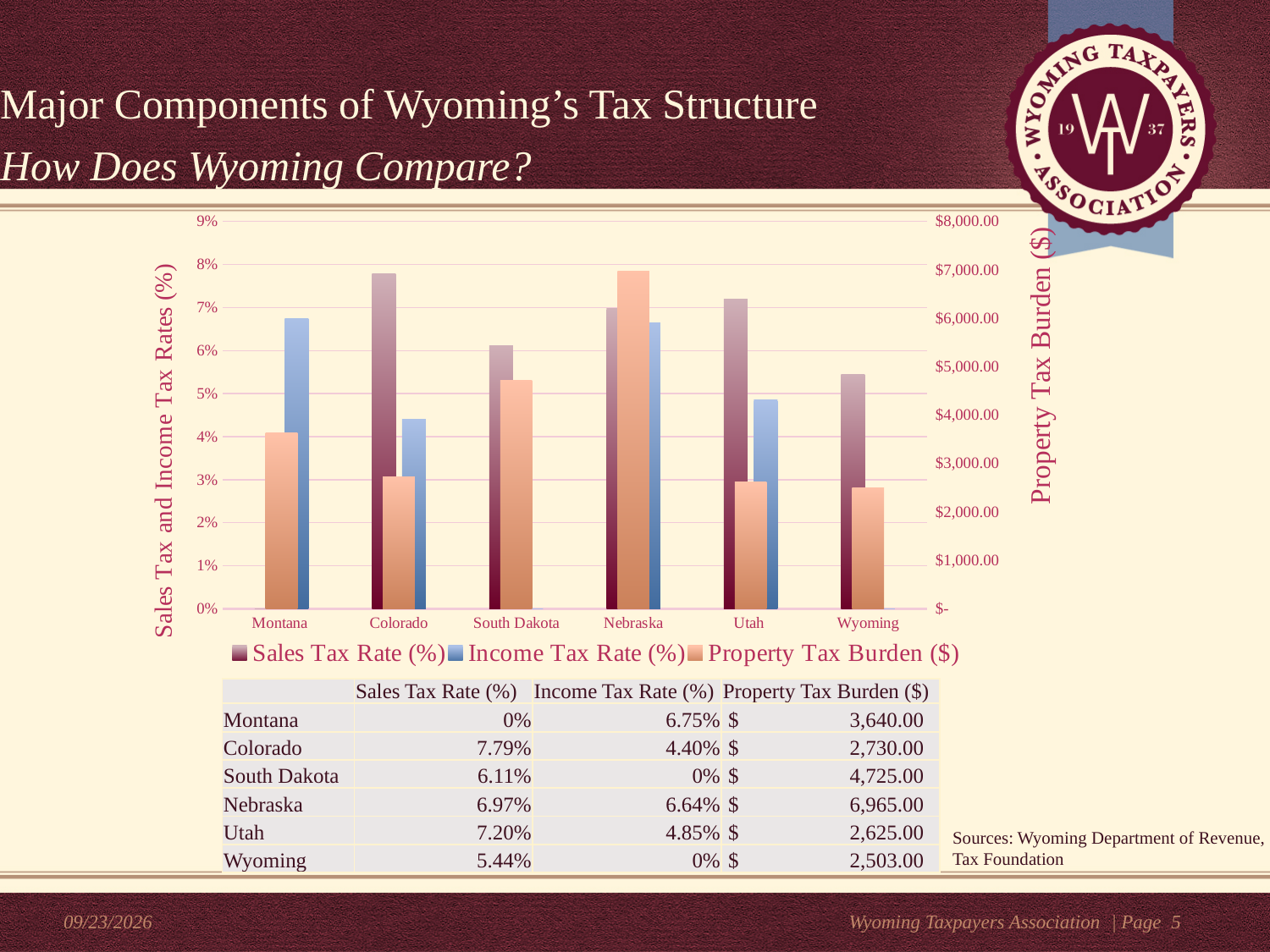
What is the Income Tax Rate (%) for Utah? 4.85% What kind of chart is shown on the slide? Bar chart How many series does the chart legend list? 3 Which state has the highest Sales Tax Rate (%)? Colorado How many states are shown on the x axis of the chart? 6 Is the Property Tax Burden ($) for Nebraska greater or less than $6,000.00? greater What is the Property Tax Burden ($) for Nebraska? $ 6,965.00 Which state has the highest Property Tax Burden ($)? Nebraska What is the Sales Tax Rate (%) for Colorado? 7.79% Which is larger, the Income Tax Rate (%) for Montana or for Colorado? Montana What is the difference between the Sales Tax Rate (%) for Colorado and for Wyoming? 2.35% Which state has the lowest Property Tax Burden ($)? Wyoming